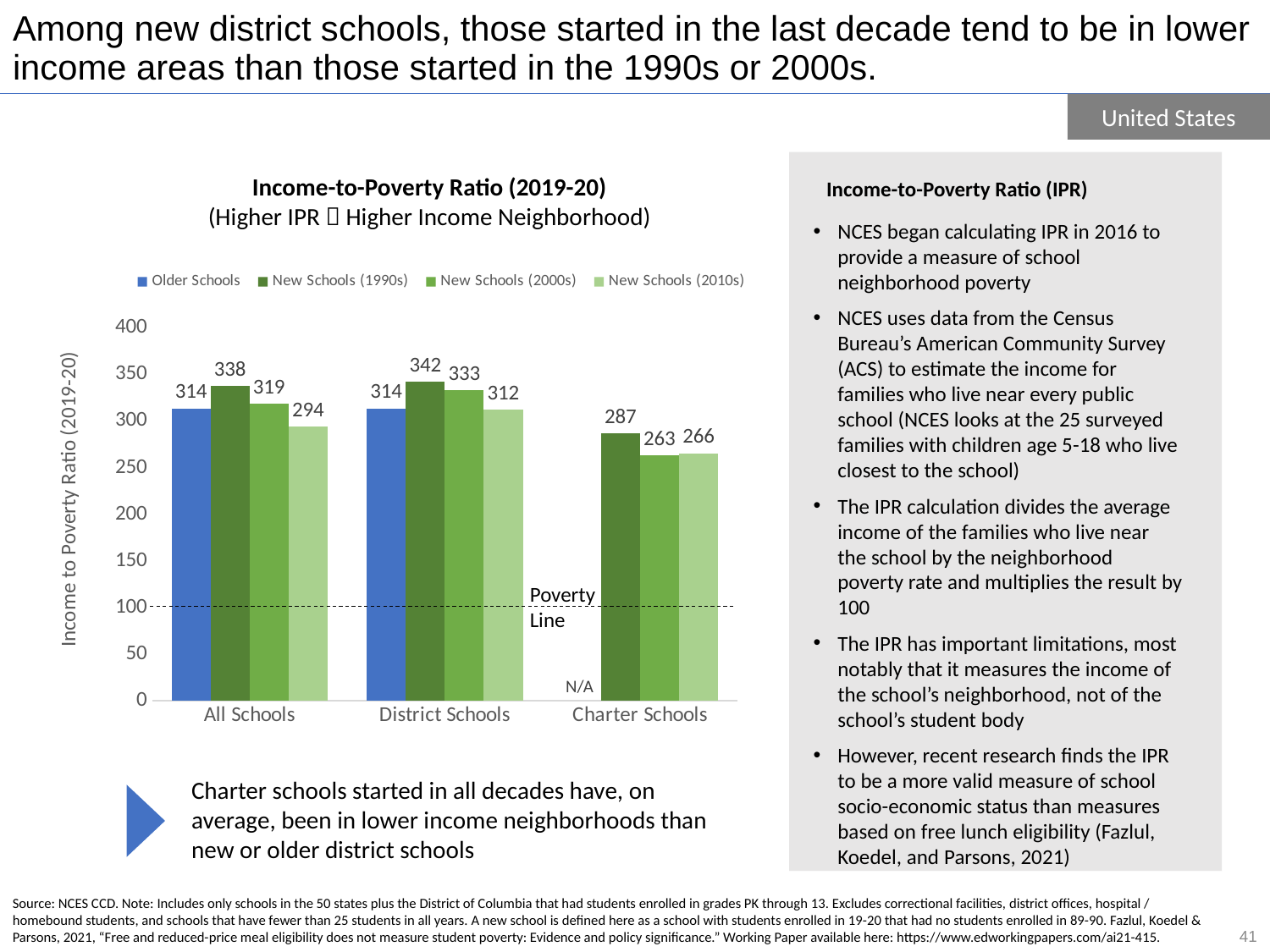
What kind of chart is shown on the slide? bar chart What is the Income-to-Poverty Ratio for New Schools (1990s) in the District Schools category? 342 Which series has the lowest Income-to-Poverty Ratio in the All Schools category? New Schools (2010s) Which series has the highest Income-to-Poverty Ratio in the District Schools category? New Schools (1990s) How many categories are shown on the x axis of the chart? 3 What value is shown for Older Schools in the Charter Schools category? N/A How many series does the chart legend list? 4 What is the Income-to-Poverty Ratio for New Schools (2010s) in the Charter Schools category? 266 Is the value for New Schools (1990s) in the Charter Schools category greater or less than 300? less What is the difference between the New Schools (1990s) and New Schools (2010s) values in the All Schools category? 44 What is the Income-to-Poverty Ratio for Older Schools in the All Schools category? 314 Which is larger: the New Schools (2000s) value for District Schools or for Charter Schools? District Schools